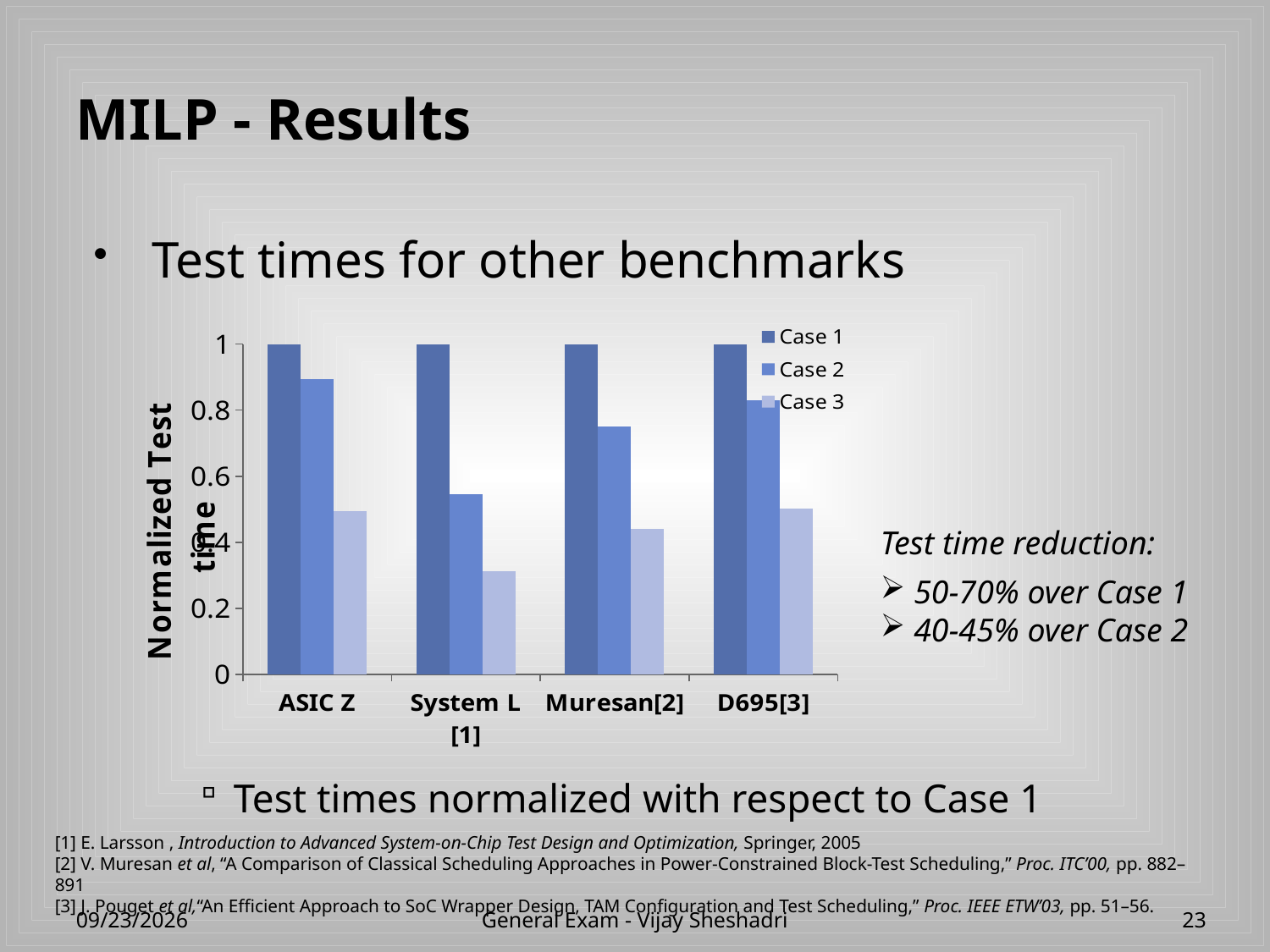
What is the Case 1 value for D695[3]? 1 Is the Case 2 value for ASIC Z greater or less than 0.8? greater How many benchmark categories are shown on the x axis of the chart? 4 Which benchmark has the highest Case 2 value? ASIC Z Is the Case 3 value for System L [1] greater or less than 0.4? less What kind of chart is shown on the slide? bar chart Which benchmark has the lowest Case 3 value? System L [1] Is the Case 2 value for Muresan[2] greater or less than 0.6? greater What is the Case 1 value for ASIC Z? 1 What is the title of the chart's vertical axis? Normalized Test time How many series does the chart's legend list? 3 Which is larger, the Case 2 value for ASIC Z or the Case 2 value for System L [1]? ASIC Z